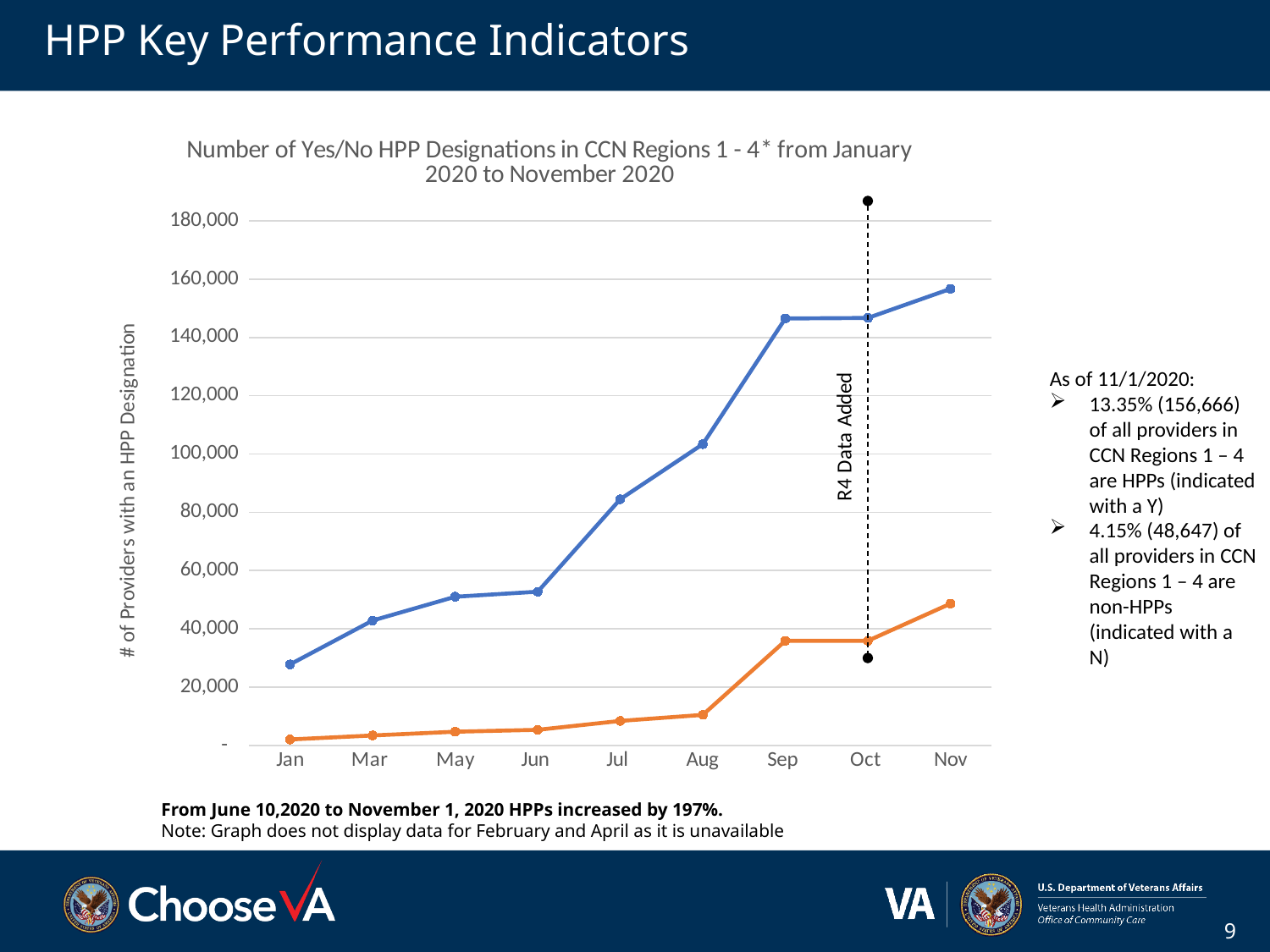
In Sep, which line has the larger value, the blue line or the orange line? Blue line Does the blue line generally rise or fall from Jan to Nov? Rise What is the title of the chart? Number of Yes/No HPP Designations in CCN Regions 1 - 4* from January 2020 to November 2020 Is the value of the blue line in Jun greater or less than 60,000? less Is the value of the orange line in Nov greater or less than 40,000? greater Is the value of the blue line in Sep greater or less than 140,000? greater How many months are plotted along the x axis of the chart? 9 What does the dashed vertical line at Oct on the chart indicate? R4 Data Added What kind of chart is shown on the slide? Line chart In which month does the blue line reach its highest value? Nov In which month is the blue line at its lowest value? Jan